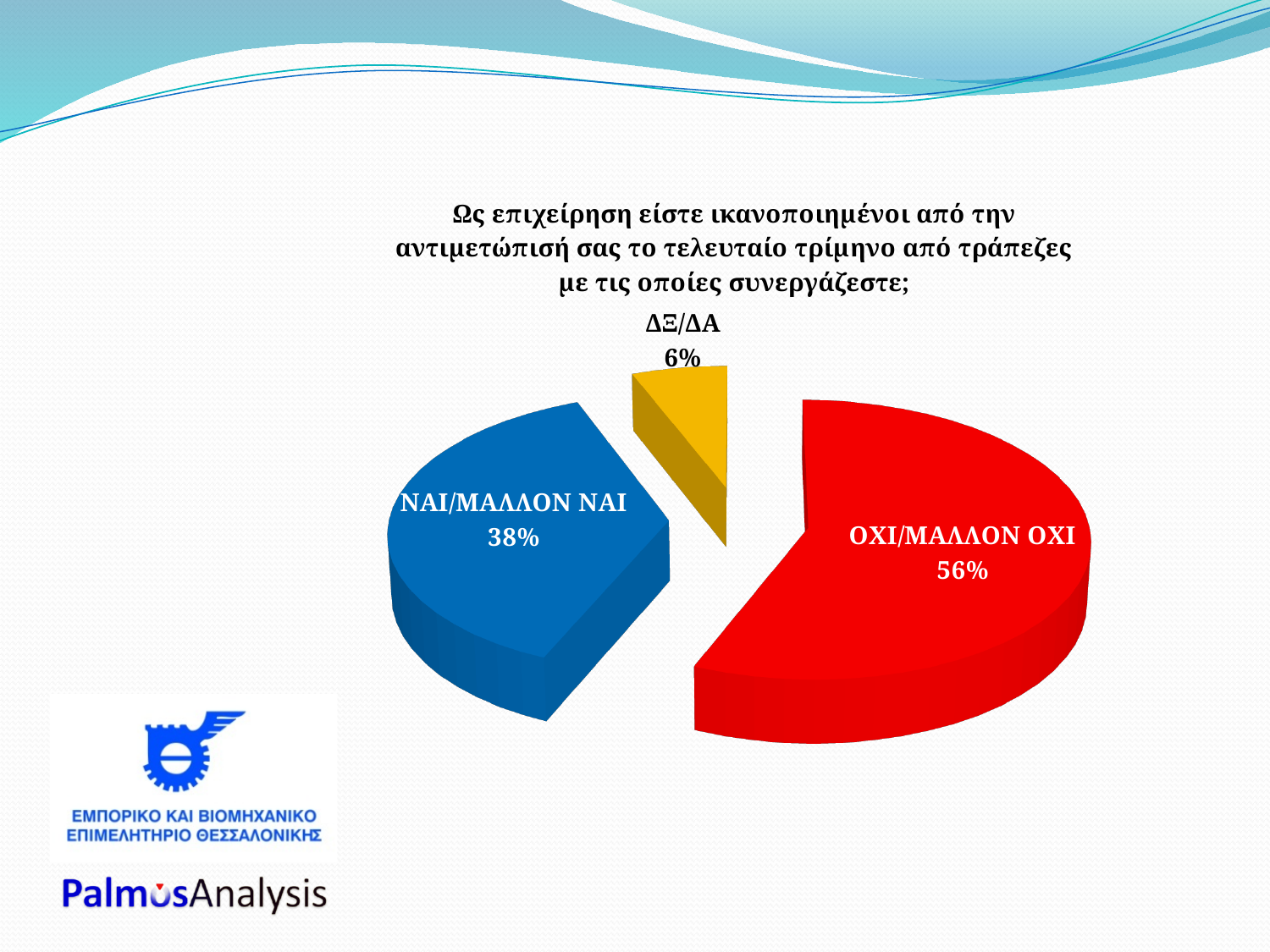
What share of the pie does ΟΧΙ/ΜΑΛΛΟΝ ΟΧΙ represent? 56% What colour is the slice for ΔΞ/ΔΑ? Yellow What colour is the slice for ΝΑΙ/ΜΑΛΛΟΝ ΝΑΙ? Blue What share of the pie does ΝΑΙ/ΜΑΛΛΟΝ ΝΑΙ represent? 38% Which category has the largest slice of the pie? ΟΧΙ/ΜΑΛΛΟΝ ΟΧΙ What kind of chart is shown on the slide? Pie chart What is the value shown for ΔΞ/ΔΑ? 6% What is the difference between the ΟΧΙ/ΜΑΛΛΟΝ ΟΧΙ and ΝΑΙ/ΜΑΛΛΟΝ ΝΑΙ shares? 18% Which category has the smallest slice of the pie? ΔΞ/ΔΑ What is the difference between the ΝΑΙ/ΜΑΛΛΟΝ ΝΑΙ and ΔΞ/ΔΑ shares? 32% Which is larger, the share for ΝΑΙ/ΜΑΛΛΟΝ ΝΑΙ or the share for ΟΧΙ/ΜΑΛΛΟΝ ΟΧΙ? ΟΧΙ/ΜΑΛΛΟΝ ΟΧΙ How many slices does the pie chart have? 3